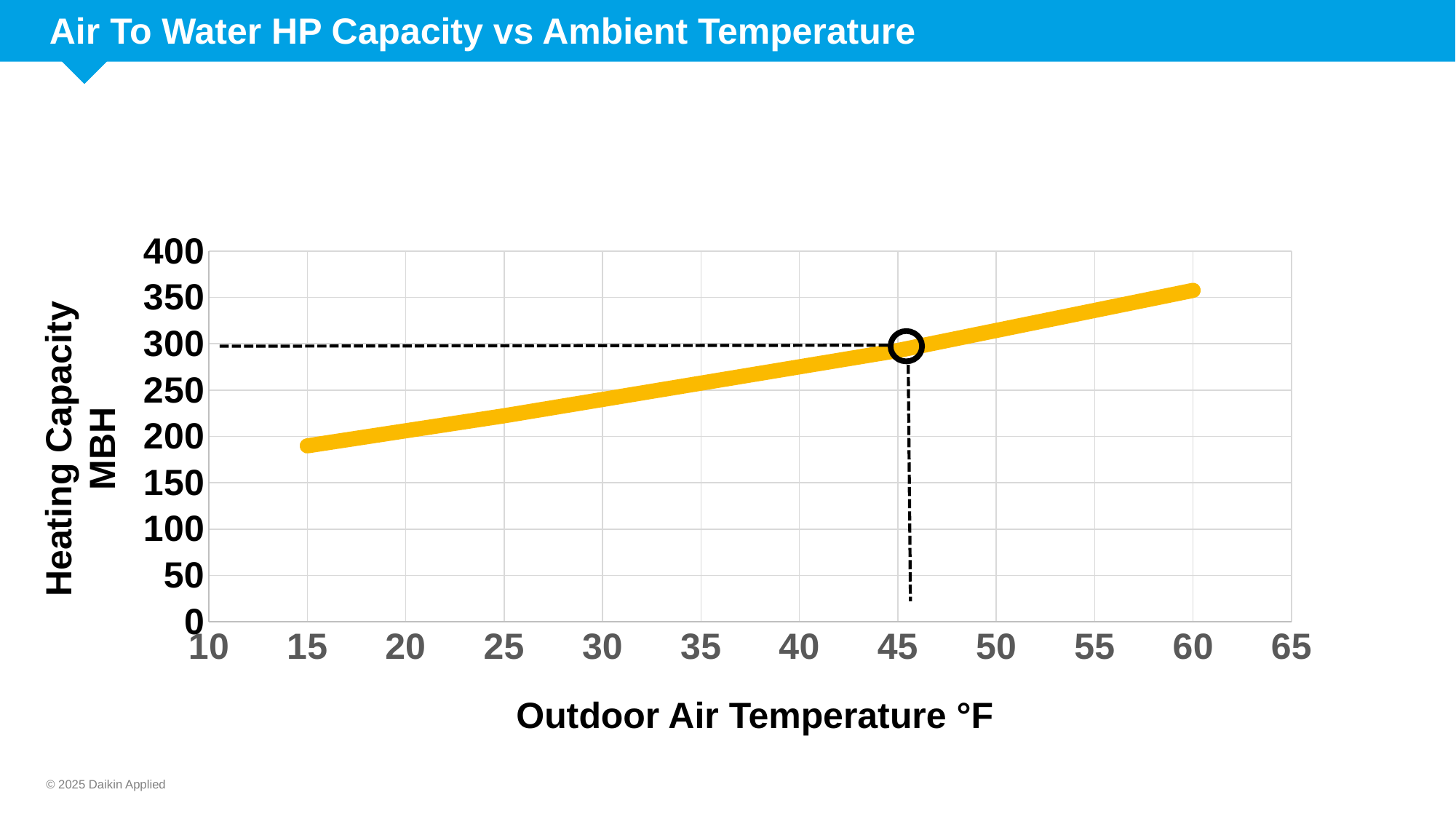
What kind of chart is shown on the slide? line chart Is the heating capacity at 60 °F outdoor air temperature greater or less than 300 MBH? greater Which has the higher heating capacity: 20 °F or 55 °F outdoor air temperature? 55 °F Is the heating capacity at the circled point on the line greater or less than 250 MBH? greater Is the heating capacity at 15 °F outdoor air temperature greater or less than 150 MBH? greater What is the label of the x axis? Outdoor Air Temperature °F What is the label of the y axis? Heating Capacity MBH Does heating capacity rise or fall as outdoor air temperature increases? rise How many lines are plotted on the chart? 1